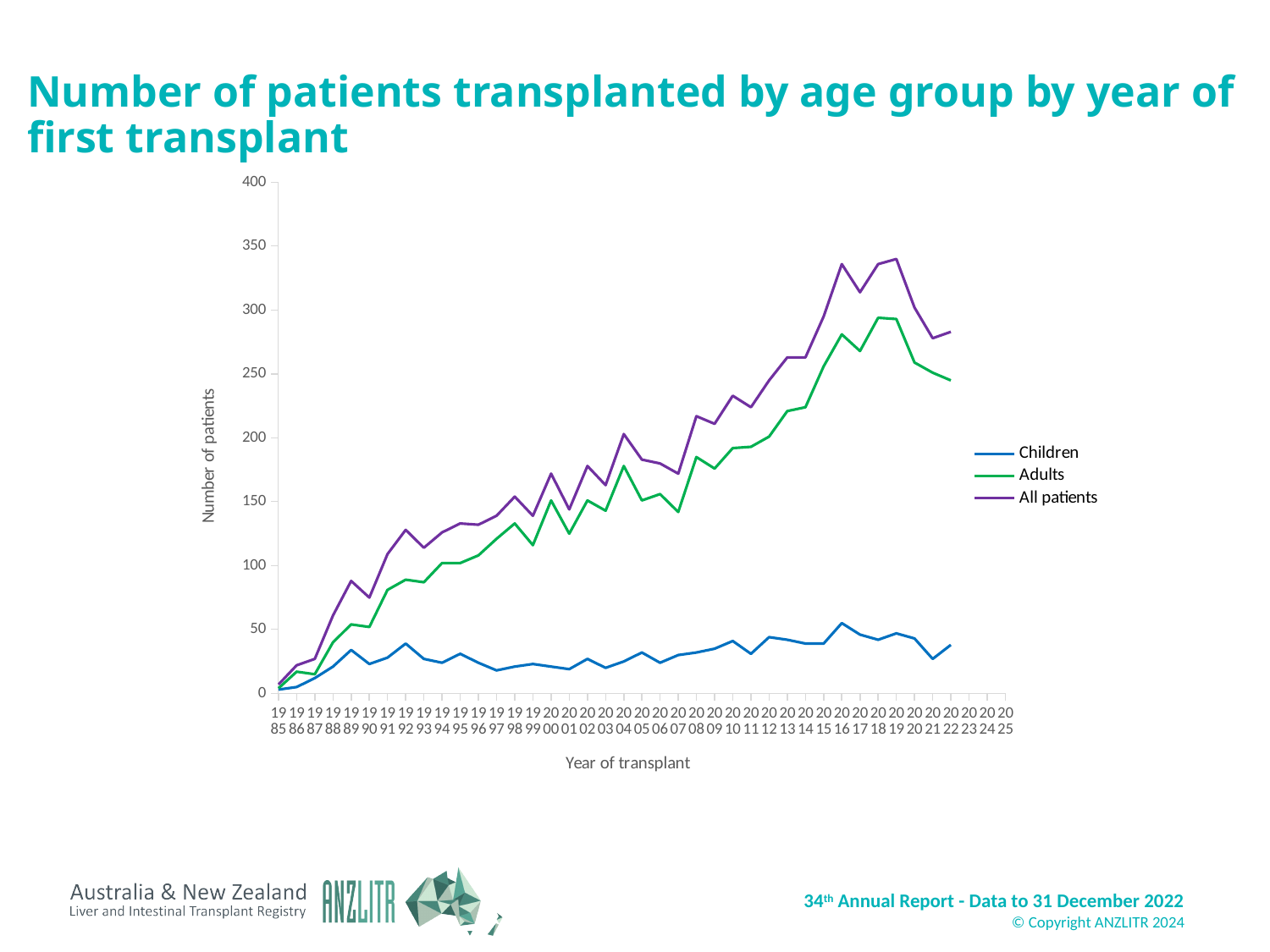
Which series has the lowest values across the chart? Children Which is larger in 2010, the value for Adults or the value for Children? Adults Is the value for All patients in 2016 greater or less than 300? greater Is the value for Adults in 2016 greater or less than 300? less What kind of chart is shown on the slide? line chart Is the value for Adults in 2013 greater or less than 200? greater What are the three series named in the legend? Children, Adults, All patients How many series does the legend list? 3 Which series has the highest values across the chart? All patients What is the label of the vertical axis? Number of patients